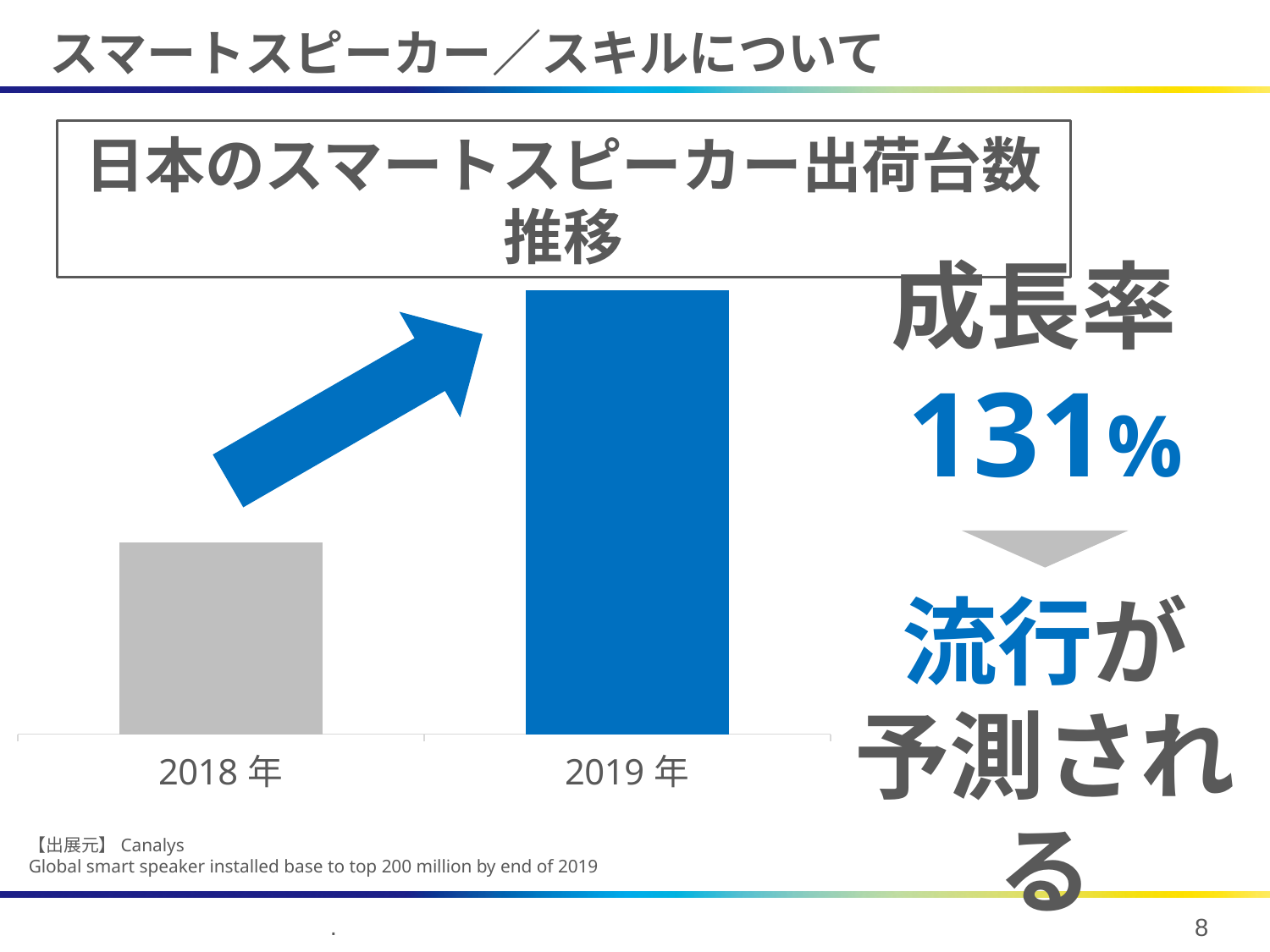
What colour is the bar for 2019年? Blue How many categories (bars) does the chart show? 2 Do the values rise or fall from 2018年 to 2019年? Rise What kind of chart is shown on the slide? Bar chart Which year has the lowest bar in the chart? 2018年 Which year has the highest bar in the chart? 2019年 What is the title of the chart? 日本のスマートスピーカー出荷台数推移 Which bar is taller, 2018年 or 2019年? 2019年